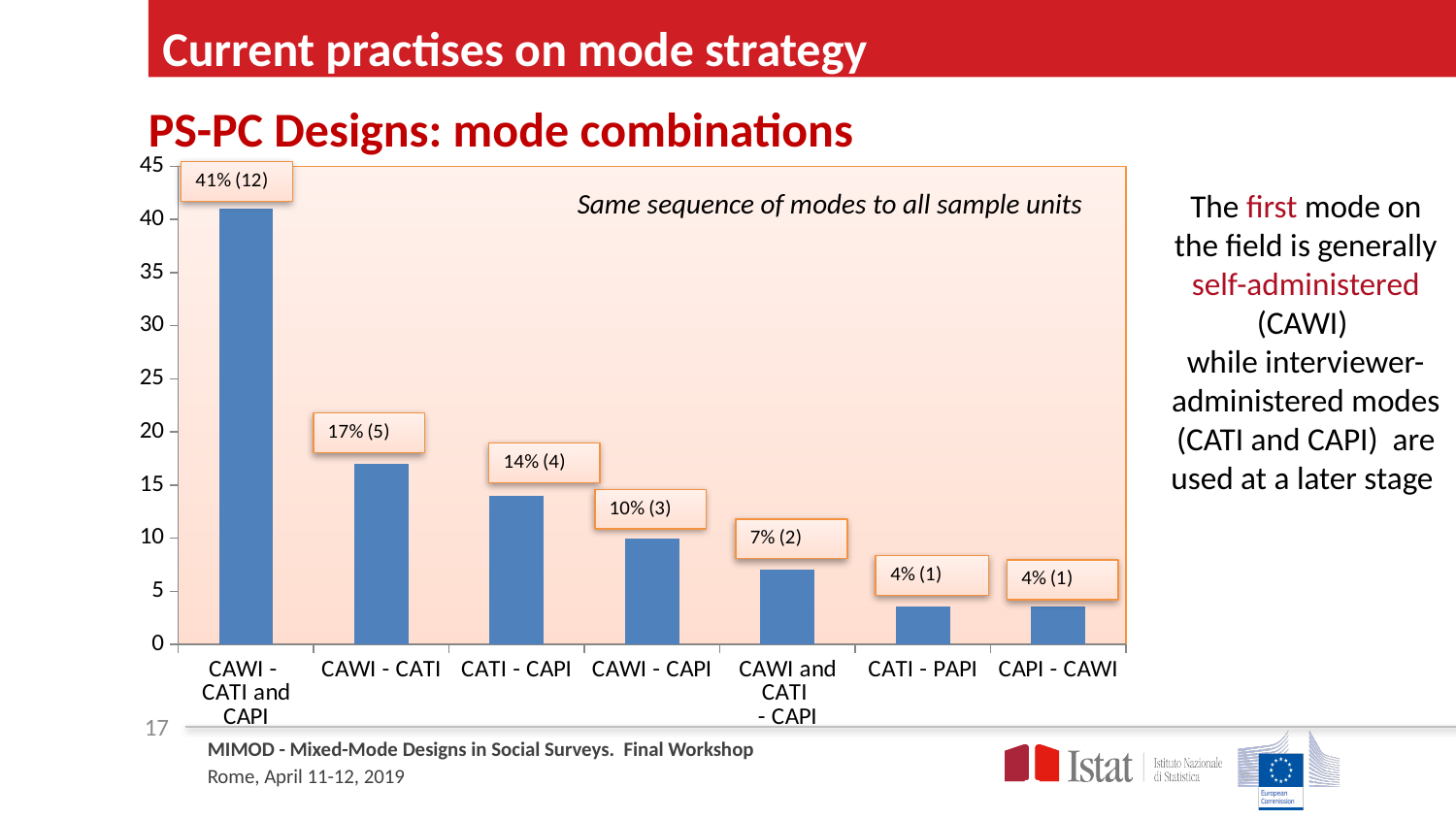
What italic text is written inside the chart area? Same sequence of modes to all sample units What is the data label shown for the CATI - CAPI bar? 14% (4) What kind of chart is shown on the slide? Bar chart How many mode combinations (categories) are shown on the x axis? 7 Do the bar values rise or fall moving from left to right along the x axis? Fall Is the value for CAWI - CATI and CAPI greater or less than 40? greater What is the data label shown for the CAWI and CATI - CAPI bar? 7% (2) What is the difference in percentage points between the CAWI - CATI bar (17%) and the CATI - CAPI bar (14%)? 3 percentage points Which mode combination has the highest bar? CAWI - CATI and CAPI Which is larger, the value for CAWI - CATI or the value for CAWI - CAPI? CAWI - CATI What is the data label shown for the CAWI - CATI and CAPI bar? 41% (12) What is the data label shown for the CAWI - CATI bar? 17% (5)